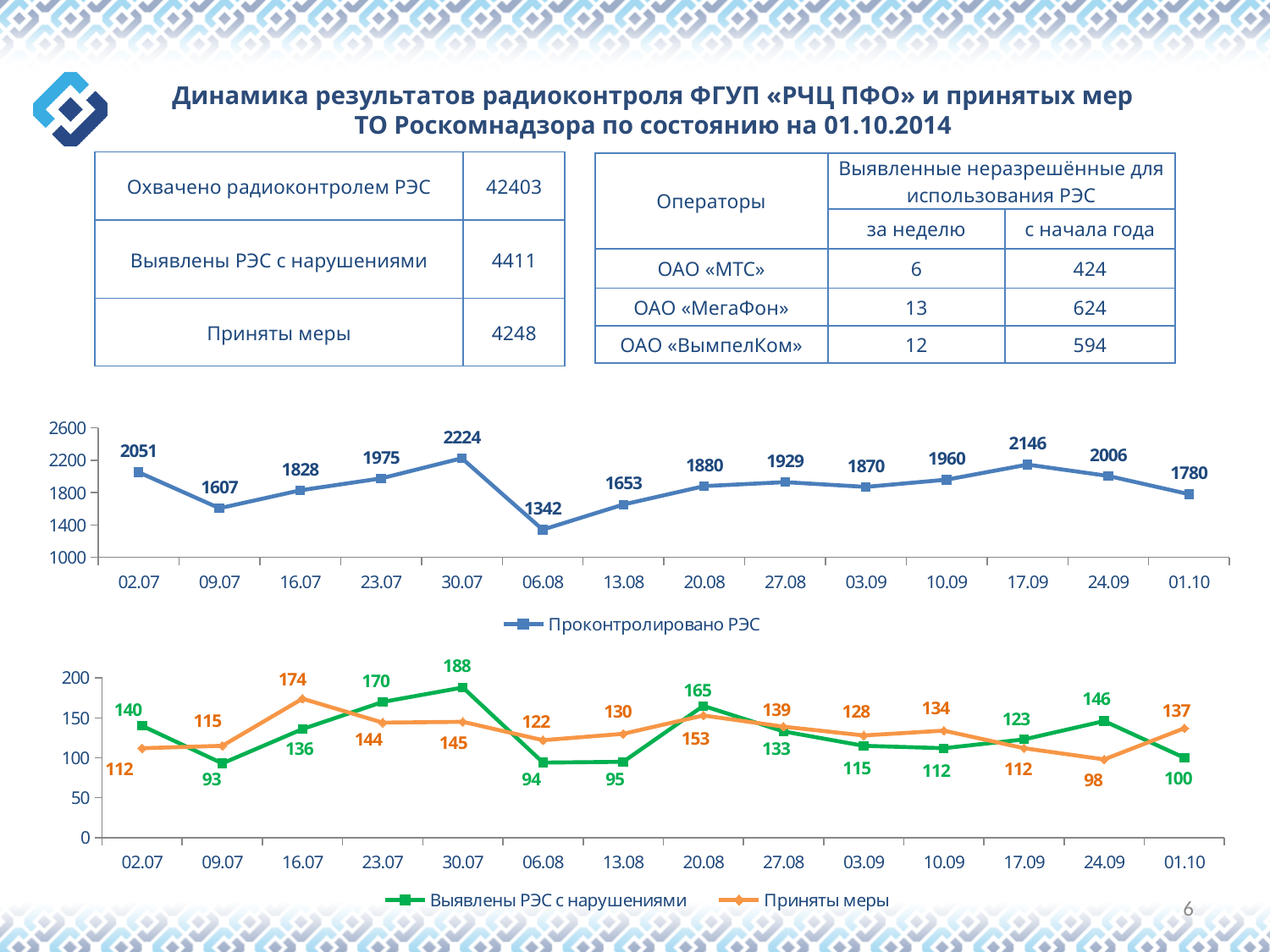
In the bottom chart, what is the value of Выявлены РЭС с нарушениями for 30.07? 188 What type of chart is the bottom chart? line chart In the top chart (Проконтролировано РЭС), which date has the lowest value? 06.08 In the top chart (Проконтролировано РЭС), what is the difference between the values for 17.09 and 01.10? 366 In the bottom chart, how many series does the legend list? 2 In the top chart (Проконтролировано РЭС), which date has the highest value? 30.07 In the top chart (Проконтролировано РЭС), what is the value for 30.07? 2224 In the bottom chart, what is the value of Приняты меры for 16.07? 174 In the top chart (Проконтролировано РЭС), how many data points are plotted? 14 In the bottom chart, which is larger on 24.09: Выявлены РЭС с нарушениями or Приняты меры? Выявлены РЭС с нарушениями In the top chart (Проконтролировано РЭС), is the value for 09.07 greater or less than 1800? less In the bottom chart, which date has the lowest value for Выявлены РЭС с нарушениями? 09.07